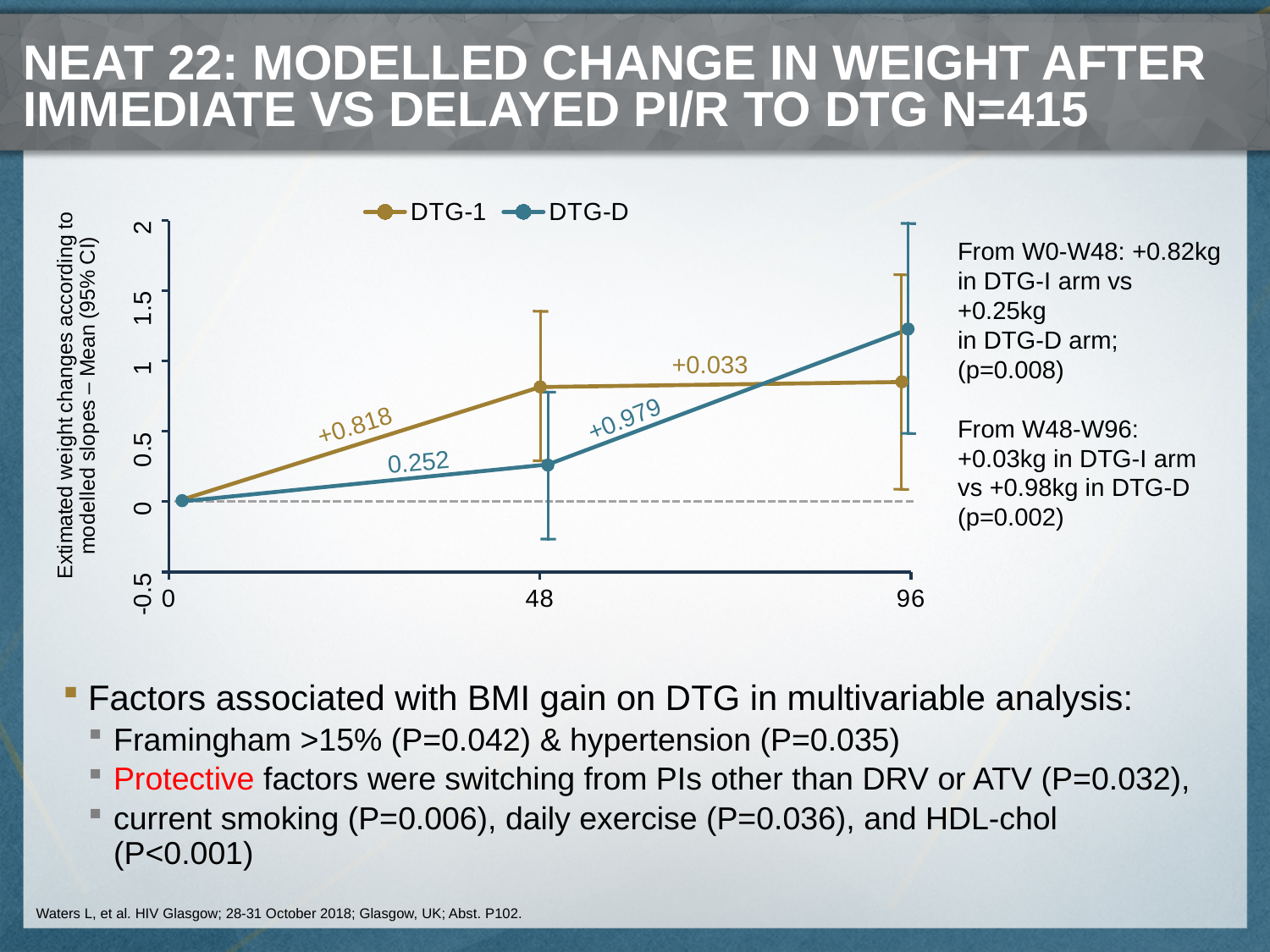
Does the DTG-D line rise or fall from week 0 to week 96? rise At week 96, which series has the higher value, DTG-1 or DTG-D? DTG-D What label is printed on the DTG-1 line between week 0 and week 48? +0.818 What label is printed on the DTG-1 line between week 48 and week 96? +0.033 How many series does the chart legend list? 2 At week 48, which series has the higher value, DTG-1 or DTG-D? DTG-1 How many time points are shown on the x axis of the chart? 3 What are the two series named in the chart legend? DTG-1 and DTG-D Is the value for DTG-D at week 48 greater or less than 0.5? less What kind of chart is shown on the slide? line chart What label is printed on the DTG-D line between week 48 and week 96? +0.979 What label is printed on the DTG-D line between week 0 and week 48? 0.252